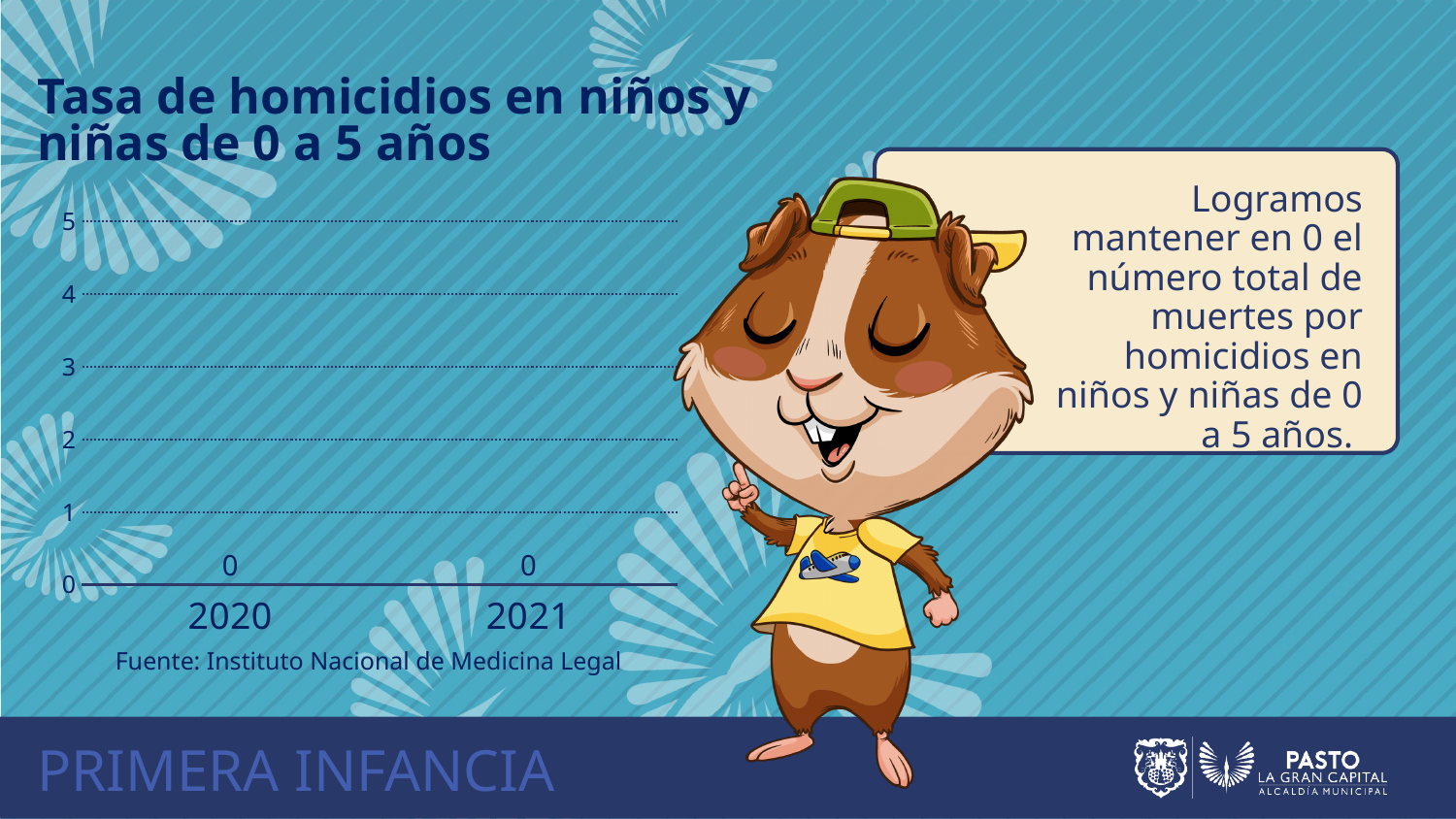
What is the value shown for 2021? 0 What is the difference between the values for 2020 and 2021? 0 Is the value for 2021 greater or less than 1? less How many years are shown on the x axis of the chart? 2 What is the title of the chart? Tasa de homicidios en niños y niñas de 0 a 5 años Do the values rise, fall or stay the same from 2020 to 2021? stay the same What is the value shown for 2020? 0 Is the value for 2020 greater or less than 2? less What kind of chart is shown on the slide? bar chart What is the highest value marked on the y axis of the chart? 5